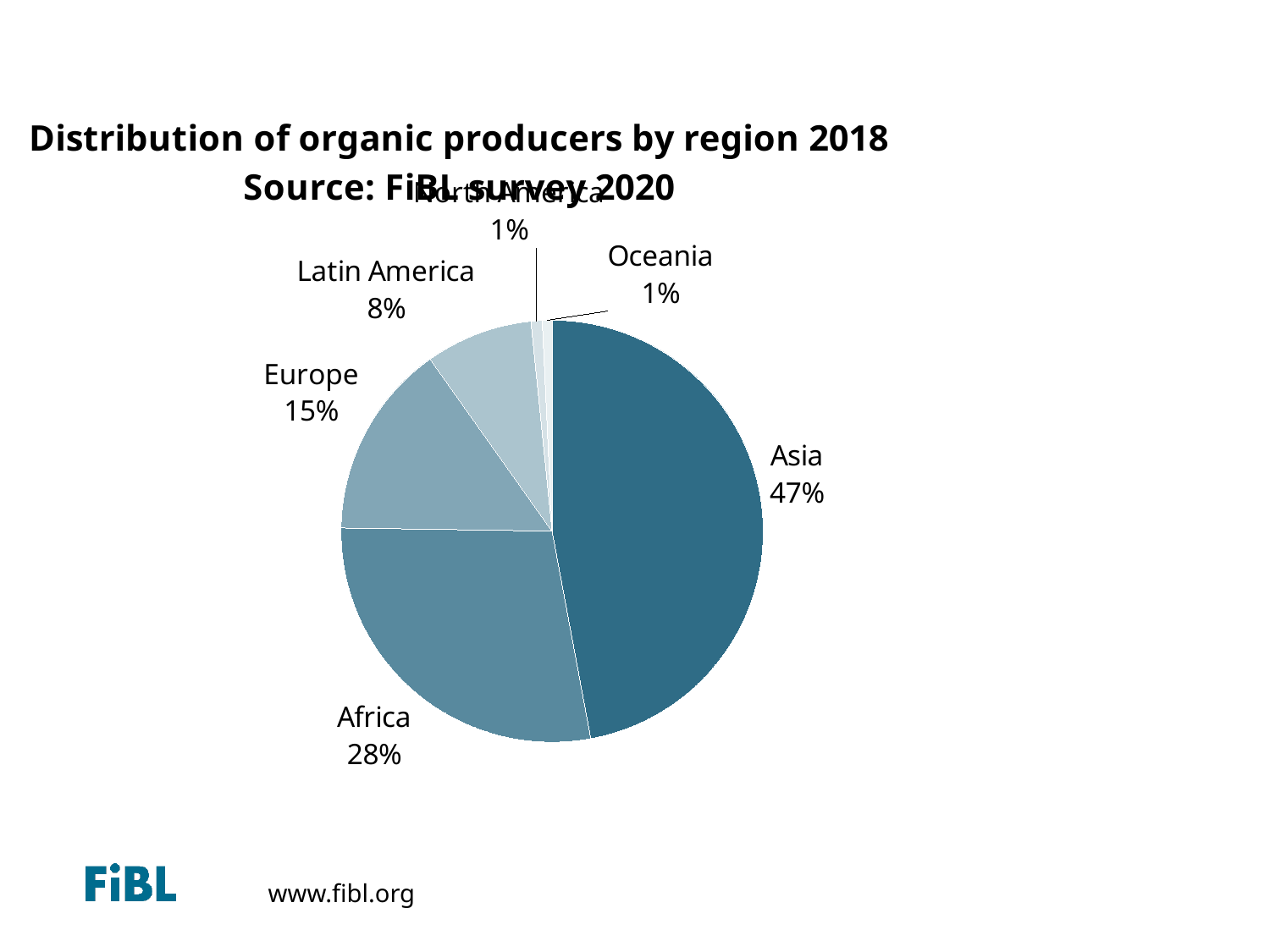
What share of organic producers is in Europe? 15% How many regions are shown in the pie chart? 6 What is the difference in percentage points between Europe's share and Latin America's share? 7 What kind of chart is shown on the slide? Pie chart What share of organic producers is in Latin America? 8% What is the title of the chart? Distribution of organic producers by region 2018 Which region has a larger share of organic producers, Africa or Europe? Africa What share of organic producers is in Oceania? 1% What share of organic producers is in Africa? 28% Which region has the largest share of organic producers? Asia What is the difference in percentage points between Asia's share and Africa's share? 19 What share of organic producers is in Asia? 47%